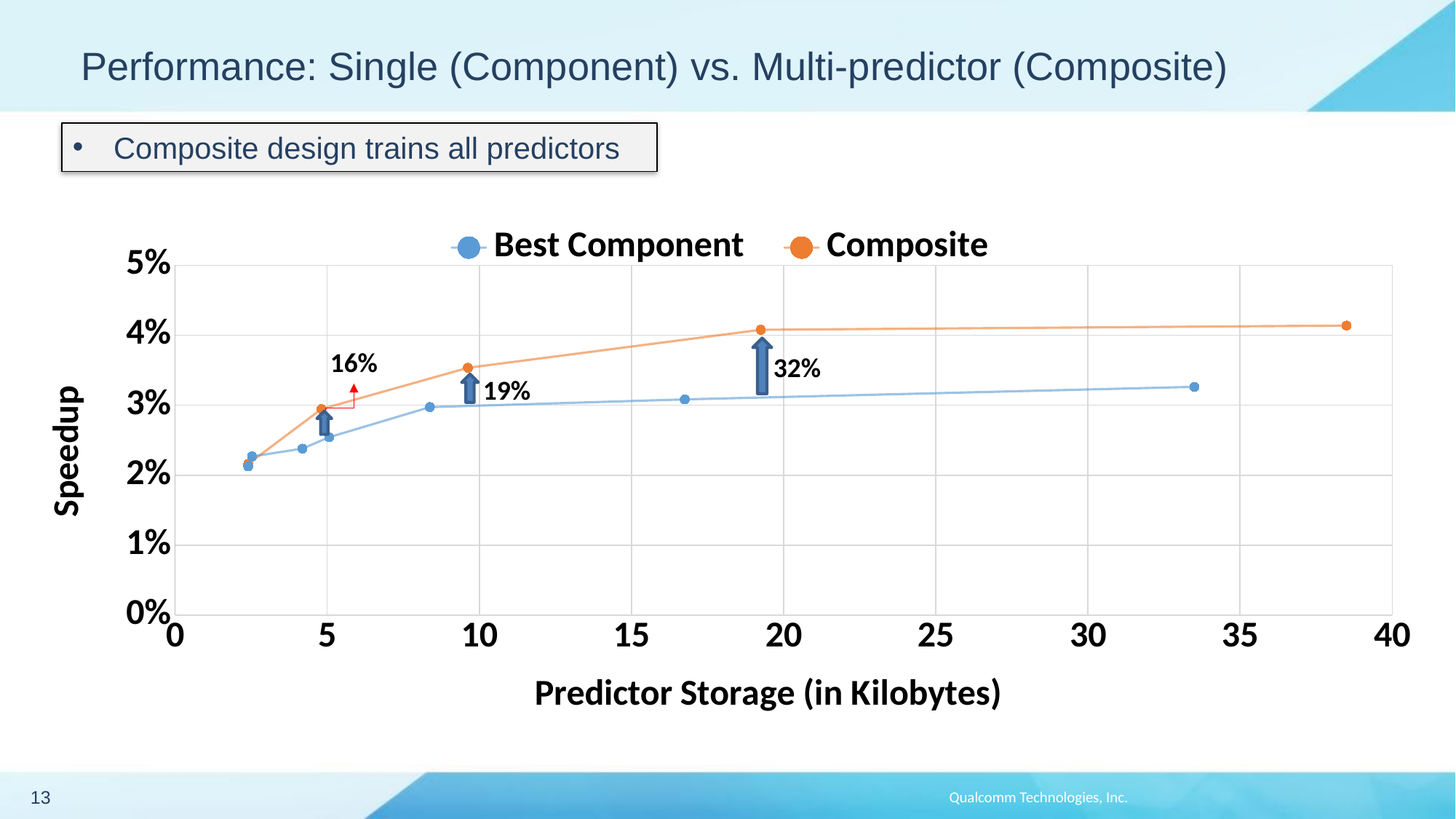
What kind of chart is shown on the slide? line chart Which series reaches the highest speedup on the chart? Composite At around 19 KB of predictor storage, which series has the higher speedup, Best Component or Composite? Composite What are the two series named in the chart legend? Best Component and Composite How many data points are plotted for the Composite series? 5 What is the title of the x axis of the chart? Predictor Storage (in Kilobytes) Is the Composite speedup at around 10 KB of predictor storage greater or less than 3%? greater Is the Best Component speedup at around 33 KB of predictor storage greater or less than 3%? greater What improvement percentage is annotated next to the arrow at around 19 KB of predictor storage? 32% How many series does the chart legend list? 2 Does the Composite series rise or fall as predictor storage increases? rises What improvement percentage is annotated next to the arrow at around 10 KB of predictor storage? 19%